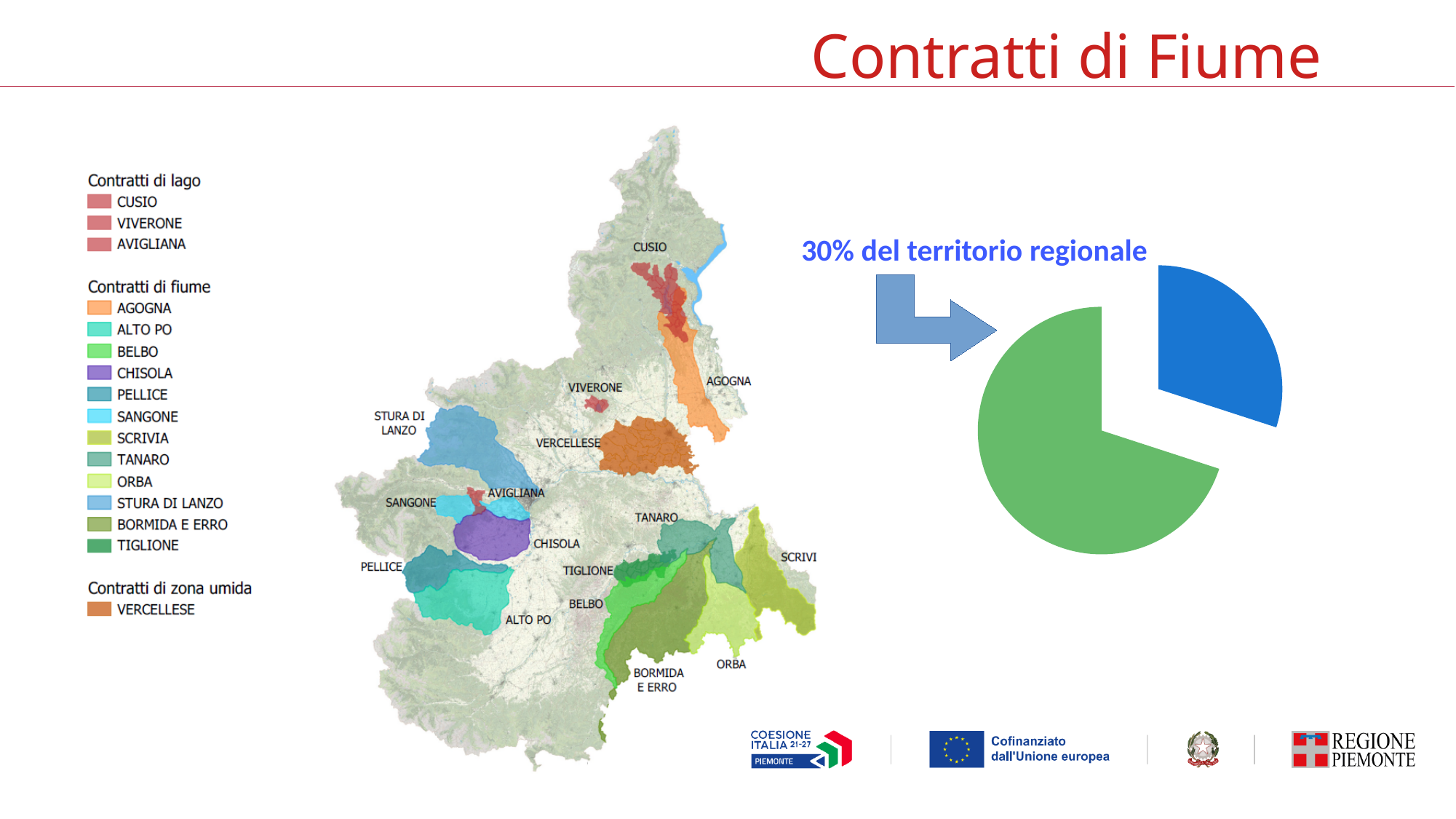
Which slice of the pie chart is pulled out (exploded) from the rest of the pie? the blue slice Which slice of the pie chart is larger, the blue one or the green one? green What text label is shown above the pie chart, next to the arrow? 30% del territorio regionale What share of the pie does the blue slice represent? 30% What kind of chart is shown on the right side of the slide? pie chart What share of the pie does the green slice represent? 70% How many slices does the pie chart have? 2 Is the blue slice of the pie chart greater or less than 50% of the pie? less